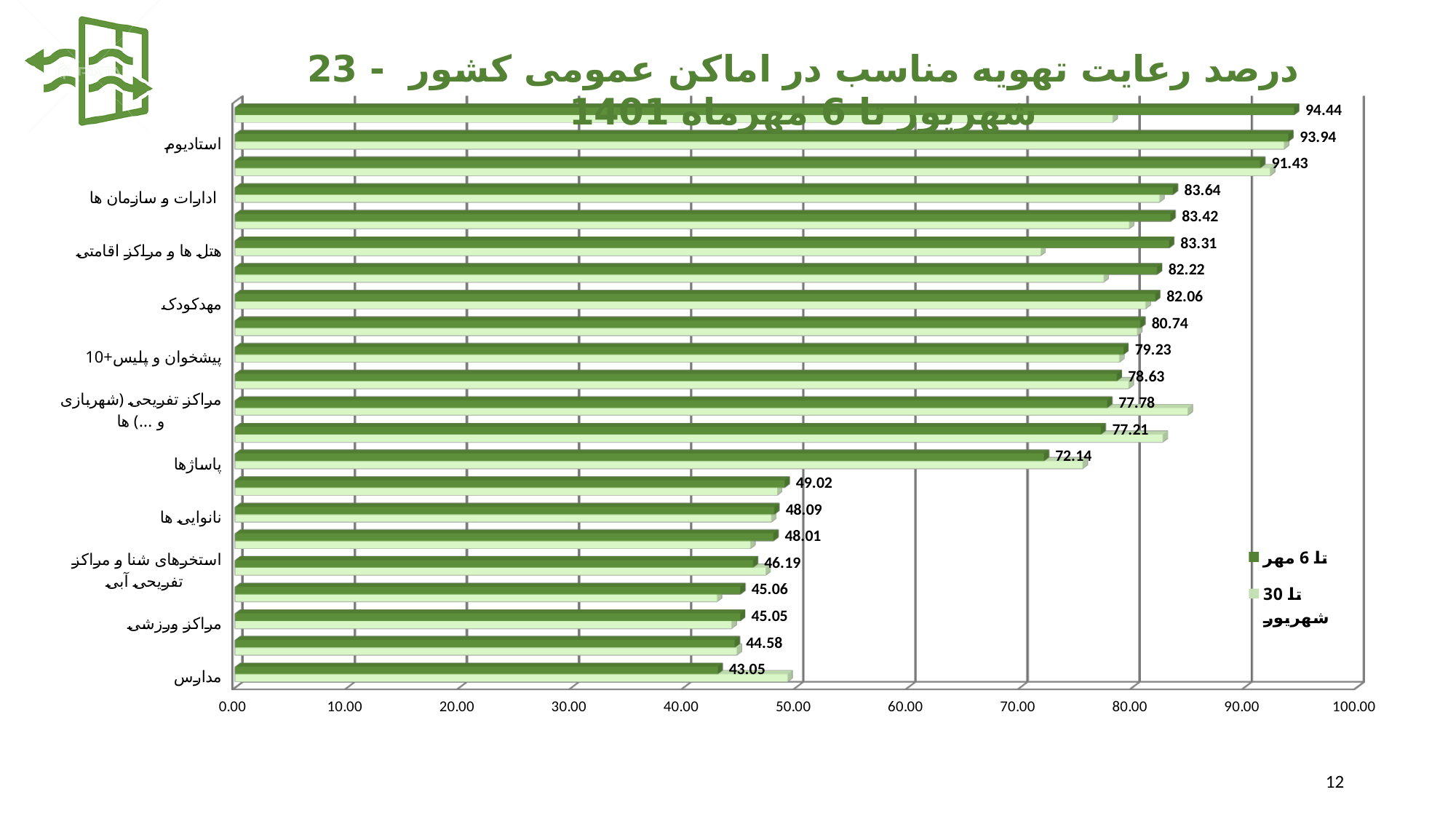
What is the lowest value labelled in the 'تا 6 مهر' series? 43.05 What type of chart is shown on the slide? bar chart How many series does the legend list? 2 Which series has its values printed as data labels on the bars? تا 6 مهر What is the 'تا 6 مهر' value for پاساژها? 72.14 What is the difference between the highest (94.44) and lowest (43.05) labelled values in the 'تا 6 مهر' series? 51.39 What are the two series named in the legend? تا 6 مهر and تا 30 شهریور What is the 'تا 6 مهر' value for مدارس? 43.05 How many bars are plotted in the 'تا 6 مهر' series? 22 What is the highest value labelled in the 'تا 6 مهر' series? 94.44 Is the 'تا 30 شهریور' value for the bar whose 'تا 6 مهر' value is 77.78 greater or less than 80? greater Is the 'تا 30 شهریور' value for the topmost bar (the one labelled 94.44 in the other series) greater or less than 80? less